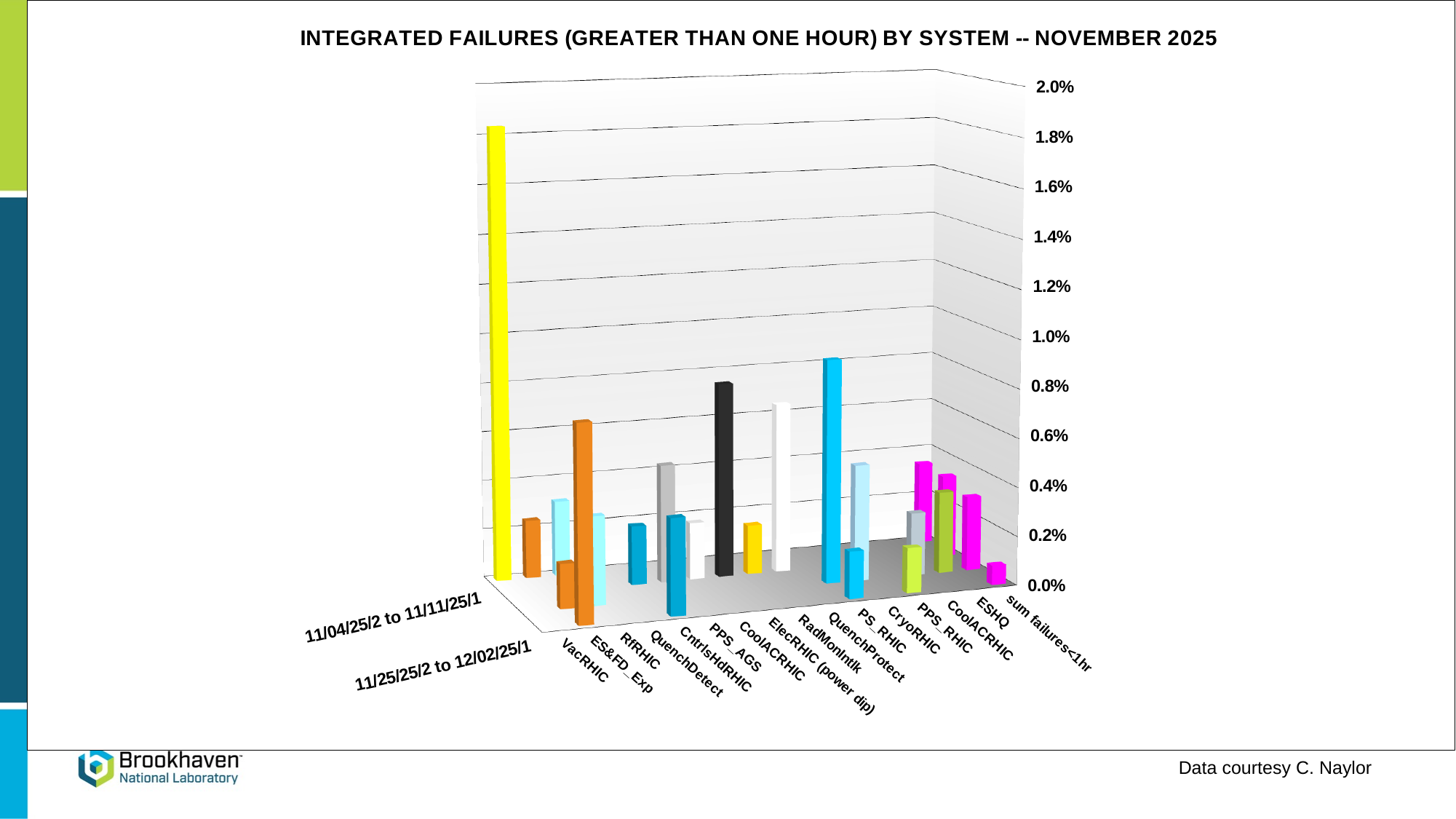
What is the highest value shown on the vertical axis of the chart? 2.0% Is the tallest bar in the chart greater or less than 1.6%? greater Which date-range series contains the tallest bar in the chart? 11/04/25/2 to 11/11/25/1 What kind of chart is shown on the slide? bar chart Is the tallest bar in the chart greater or less than 1.0%? greater How many system categories are labelled along the x axis of the chart? 16 What is the title of the chart? INTEGRATED FAILURES (GREATER THAN ONE HOUR) BY SYSTEM -- NOVEMBER 2025